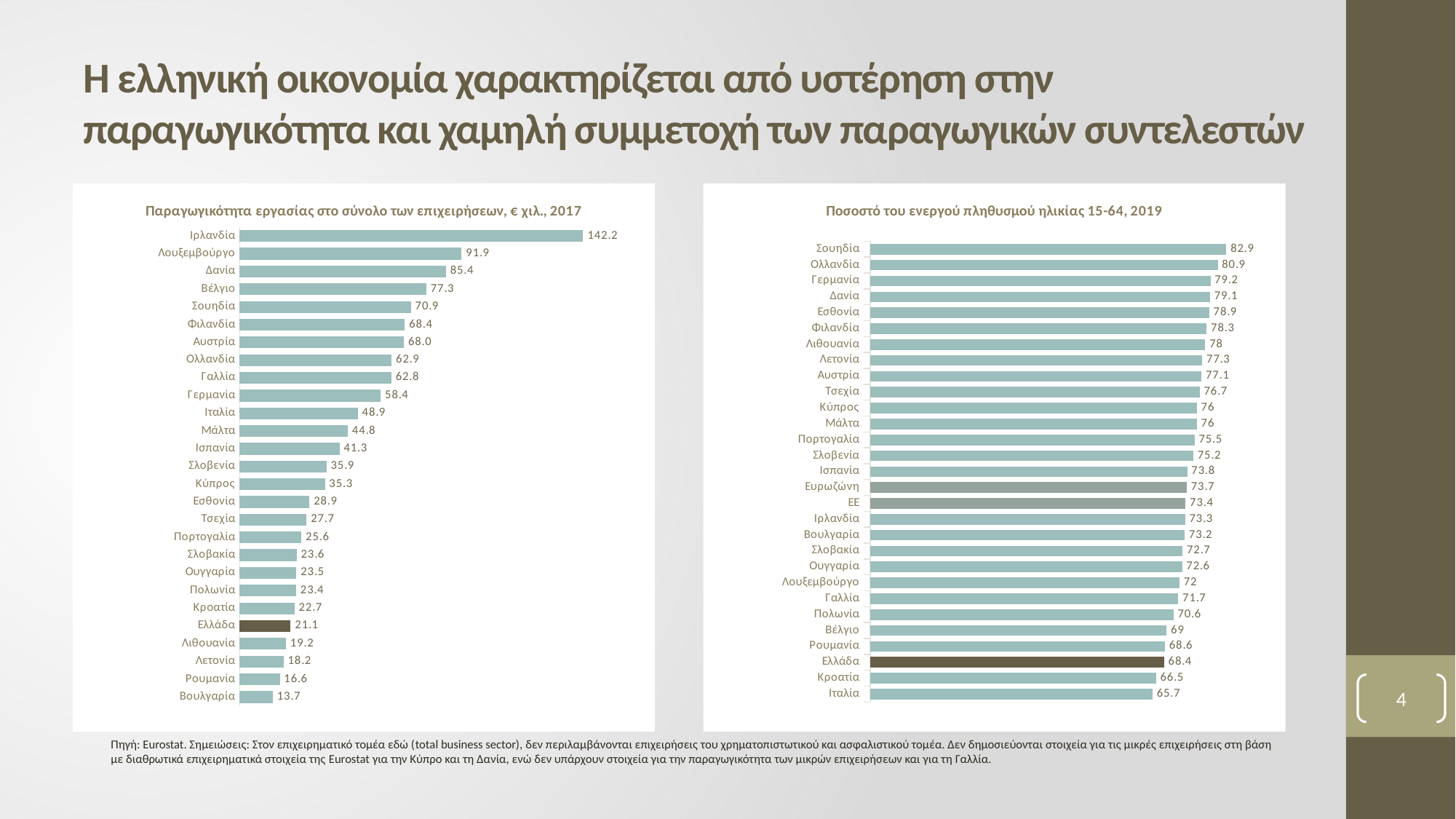
In the left chart (Παραγωγικότητα εργασίας, 2017), which country has the highest value? Ιρλανδία In the left chart (Παραγωγικότητα εργασίας, 2017), which is larger, the value for Ιταλία or the value for Ισπανία? Ιταλία In the right chart (Ποσοστό του ενεργού πληθυσμού ηλικίας 15-64, 2019), which country has the highest value? Σουηδία In the left chart (Παραγωγικότητα εργασίας, 2017), what is the difference between the values for Ιρλανδία and Λουξεμβούργο? 50.3 In the right chart (Ποσοστό του ενεργού πληθυσμού ηλικίας 15-64, 2019), which category has the lowest value? Ιταλία In the right chart (Ποσοστό του ενεργού πληθυσμού ηλικίας 15-64, 2019), what is the value for ΕΕ? 73.4 In the left chart (Παραγωγικότητα εργασίας, 2017), how many countries are shown? 27 In the right chart (Ποσοστό του ενεργού πληθυσμού ηλικίας 15-64, 2019), what is the difference between the values for Σουηδία and Ελλάδα? 14.5 What type of chart is the left chart (Παραγωγικότητα εργασίας, 2017)? Bar chart In the left chart (Παραγωγικότητα εργασίας, 2017), which country has the lowest value? Βουλγαρία In the right chart (Ποσοστό του ενεργού πληθυσμού ηλικίας 15-64, 2019), what is the value for Ελλάδα? 68.4 In the left chart (Παραγωγικότητα εργασίας στο σύνολο των επιχειρήσεων, € χιλ., 2017), what is the value for Ελλάδα? 21.1